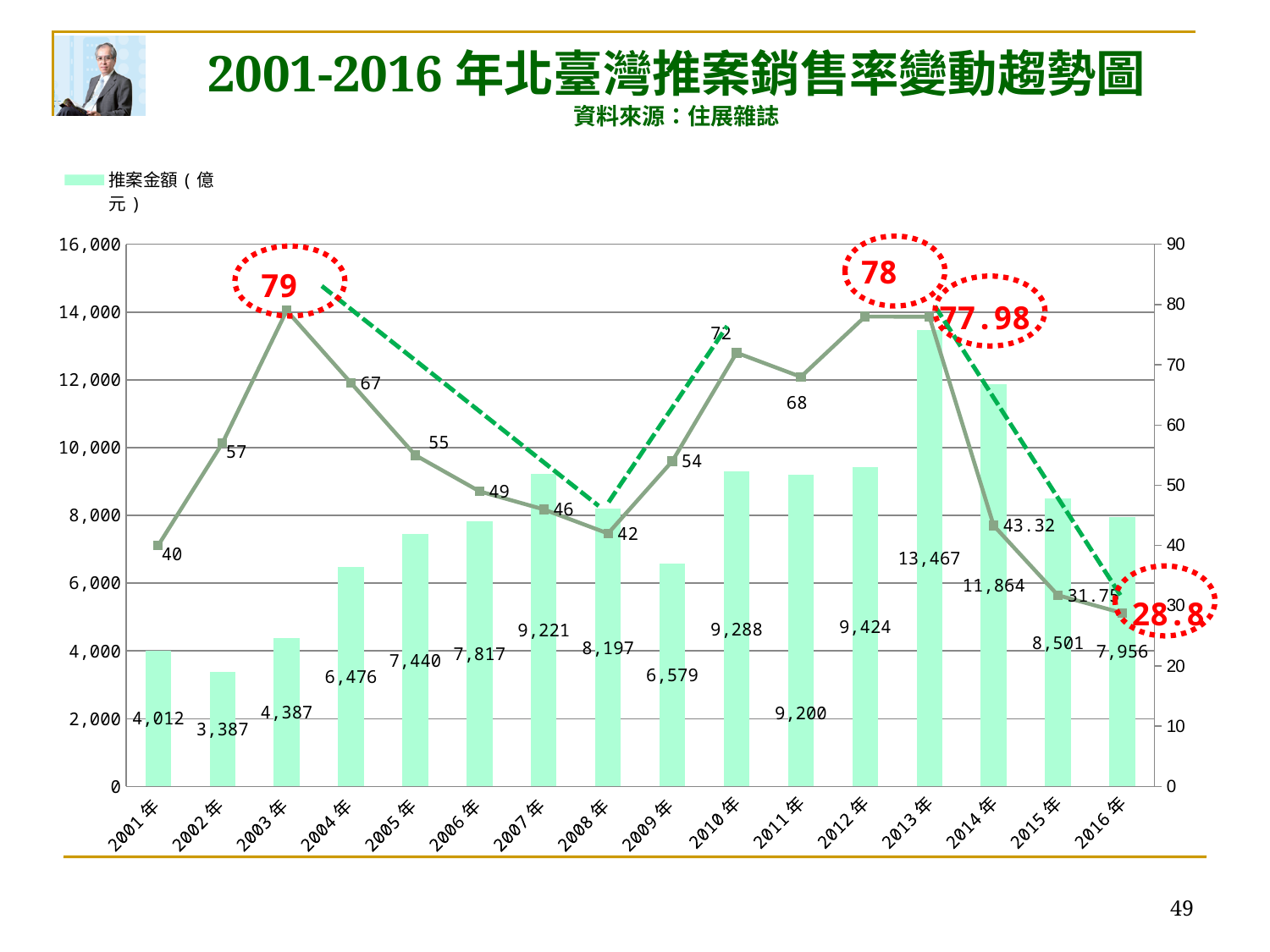
What kind of chart is this? Combined bar and line chart What is the 推案金額 (億元) bar value for 2002年? 3,387 Which is larger, the 推案金額 bar for 2010年 or for 2011年? 2010年 What is the difference between the 推案金額 bars for 2013年 and 2014年? 1,603 Which year has the highest 推案金額 bar? 2013年 What is the source cited under the chart title? 住展雜誌 What sales-rate value is labelled on the line for 2016年? 28.8 What sales-rate value is labelled on the line for 2003年? 79 What is the 推案金額 (億元) bar value for 2013年? 13,467 Which year has the lowest 推案金額 bar? 2002年 Does the line value rise or fall from 2013年 to 2016年? Fall How many years are shown on the x axis? 16